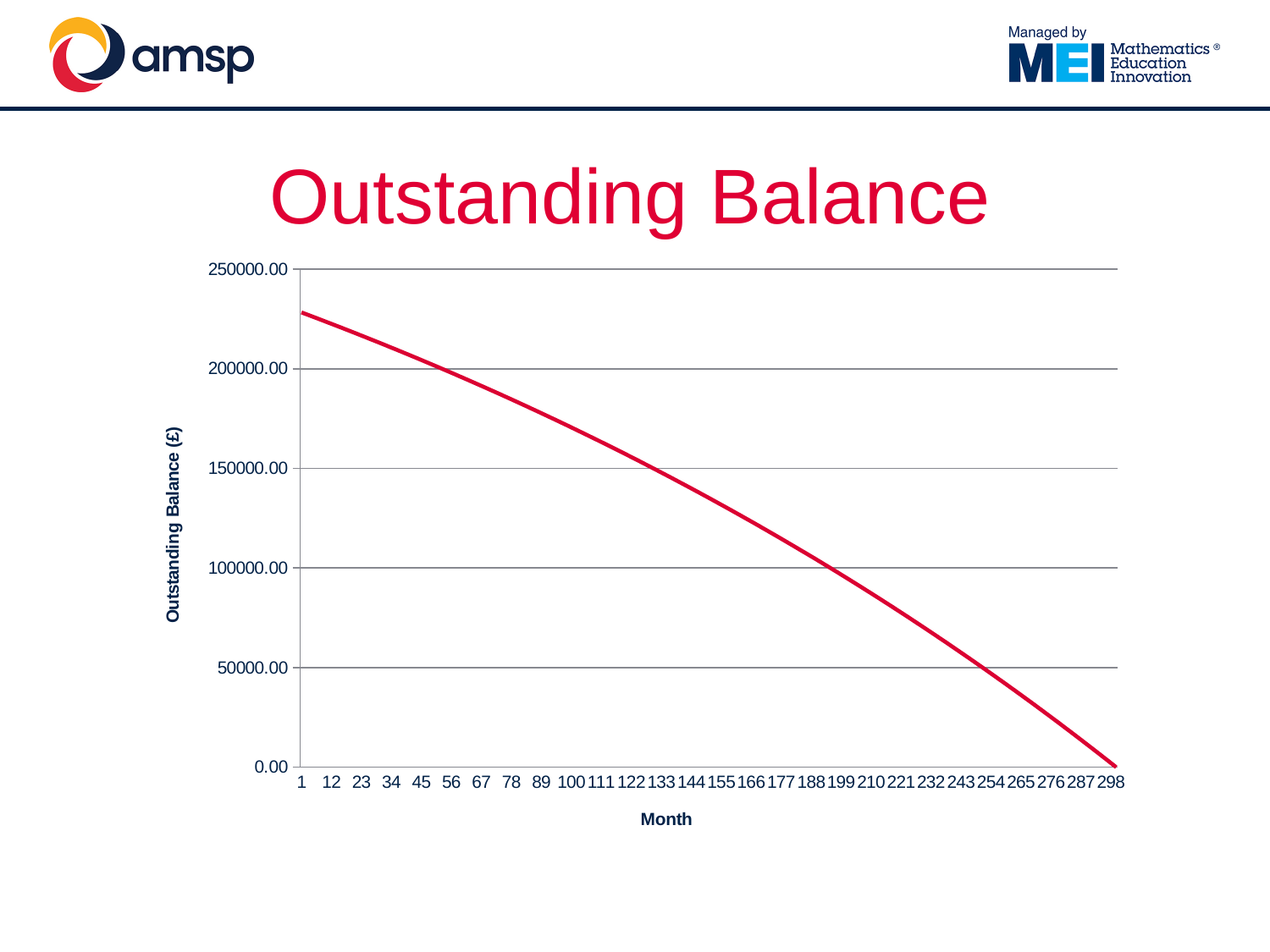
What is the title of the chart? Outstanding Balance What is the label on the vertical axis? Outstanding Balance (£) At which month is the outstanding balance highest? 1 Does the outstanding balance rise or fall as the month increases? fall What kind of chart is shown on the slide? line chart Is the outstanding balance at month 232 greater or less than 100000.00? less Is the outstanding balance at month 298 greater or less than 50000.00? less Is the outstanding balance at month 166 greater or less than 100000.00? greater Which is larger, the outstanding balance at month 100 or at month 210? month 100